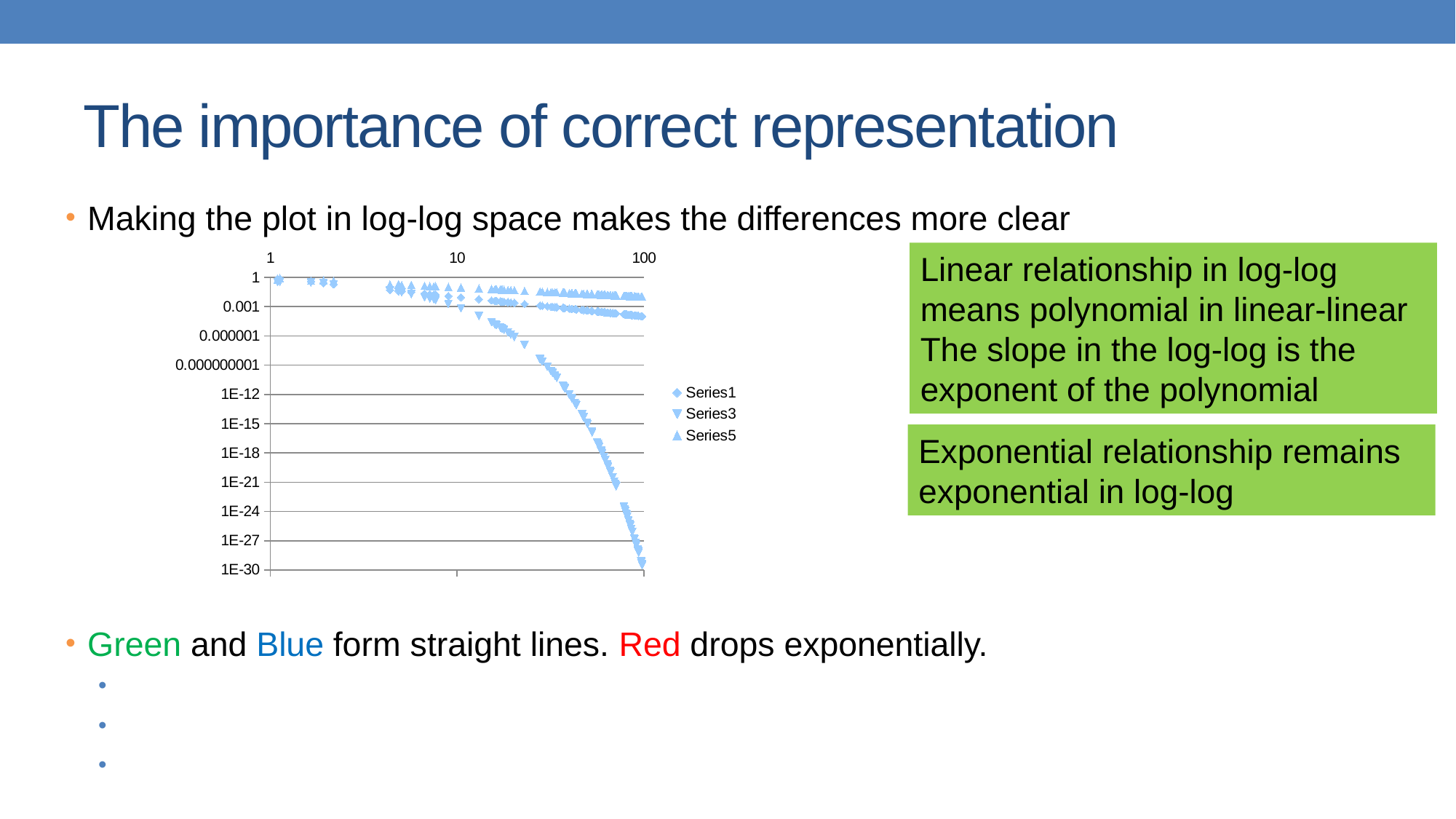
At x = 100, which is larger, the value for Series1 or the value for Series5? Series5 What are the names of the series listed in the chart legend? Series1, Series3, Series5 Is the value for Series1 at x = 100 greater or less than 0.001? less Is the value for Series5 at x = 100 greater or less than 0.000001? greater Which series drops most steeply as x increases toward 100? Series3 What is the lowest tick label shown on the chart's y axis? 1E-30 How many series does the chart legend list? 3 Which series has the lowest value at x = 100? Series3 Is the value for Series3 at x = 100 greater or less than 1E-21? less What kind of chart is shown on the slide? scatter chart Do the values of Series3 rise or fall as x increases along the x axis? fall Which series has the highest value at x = 100? Series5